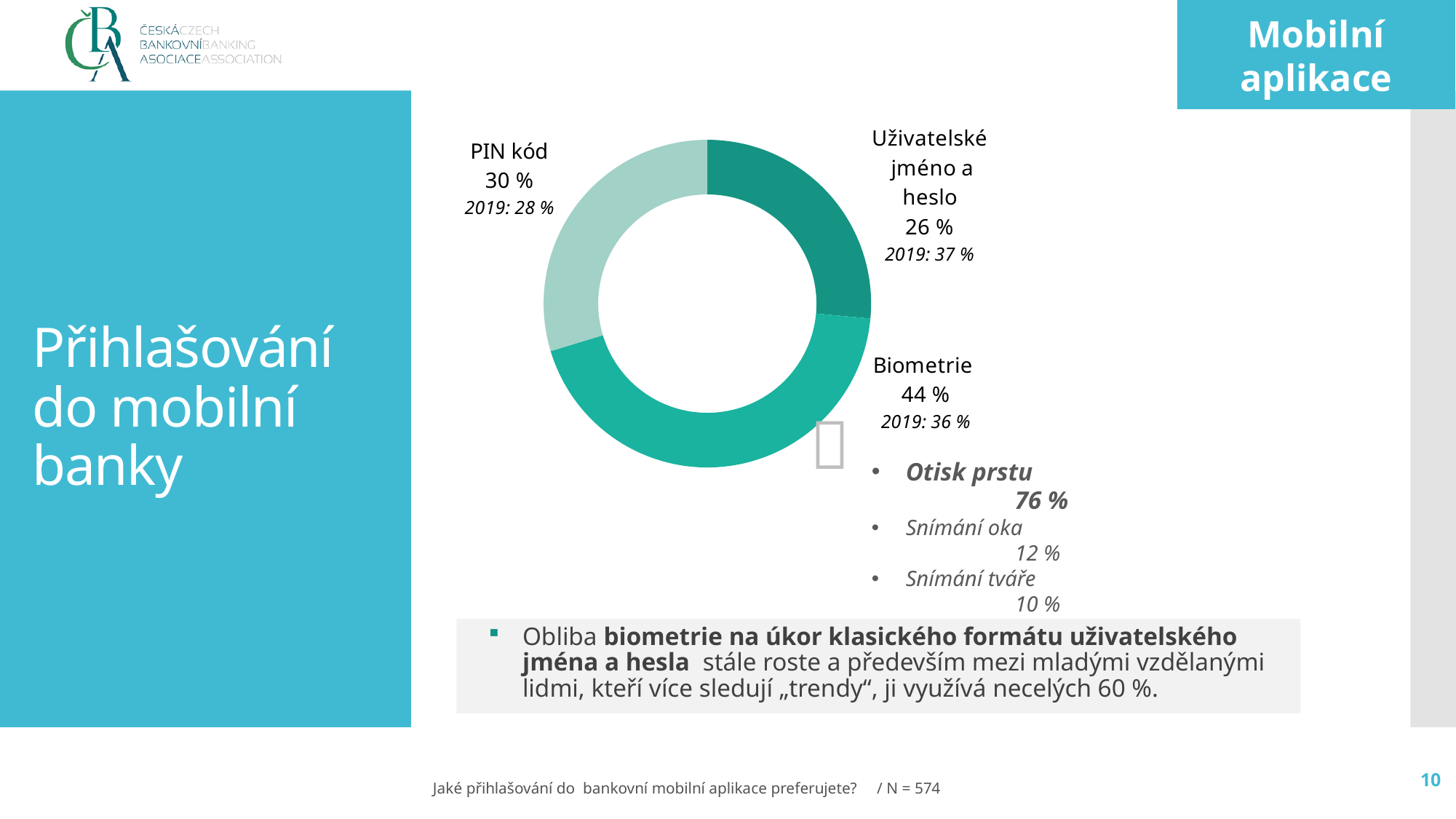
By how many percentage points did the Uživatelské jméno a heslo share change from 2019 to the current value? 11 % How many categories does the donut chart show? 3 What was the 2019 value shown for Biometrie? 36 % Which category has the largest slice in the donut chart? Biometrie What is the difference between the Biometrie share and the PIN kód share in the donut chart? 14 % What value is shown for Uživatelské jméno a heslo in the donut chart? 26 % What type of chart is shown on the slide? Donut (pie) chart Which is larger in the donut chart, PIN kód or Uživatelské jméno a heslo? PIN kód What value is shown for PIN kód in the donut chart? 30 % What was the 2019 value shown for Uživatelské jméno a heslo? 37 % Which category has the smallest slice in the donut chart? Uživatelské jméno a heslo What share of the donut chart is labelled Biometrie? 44 %